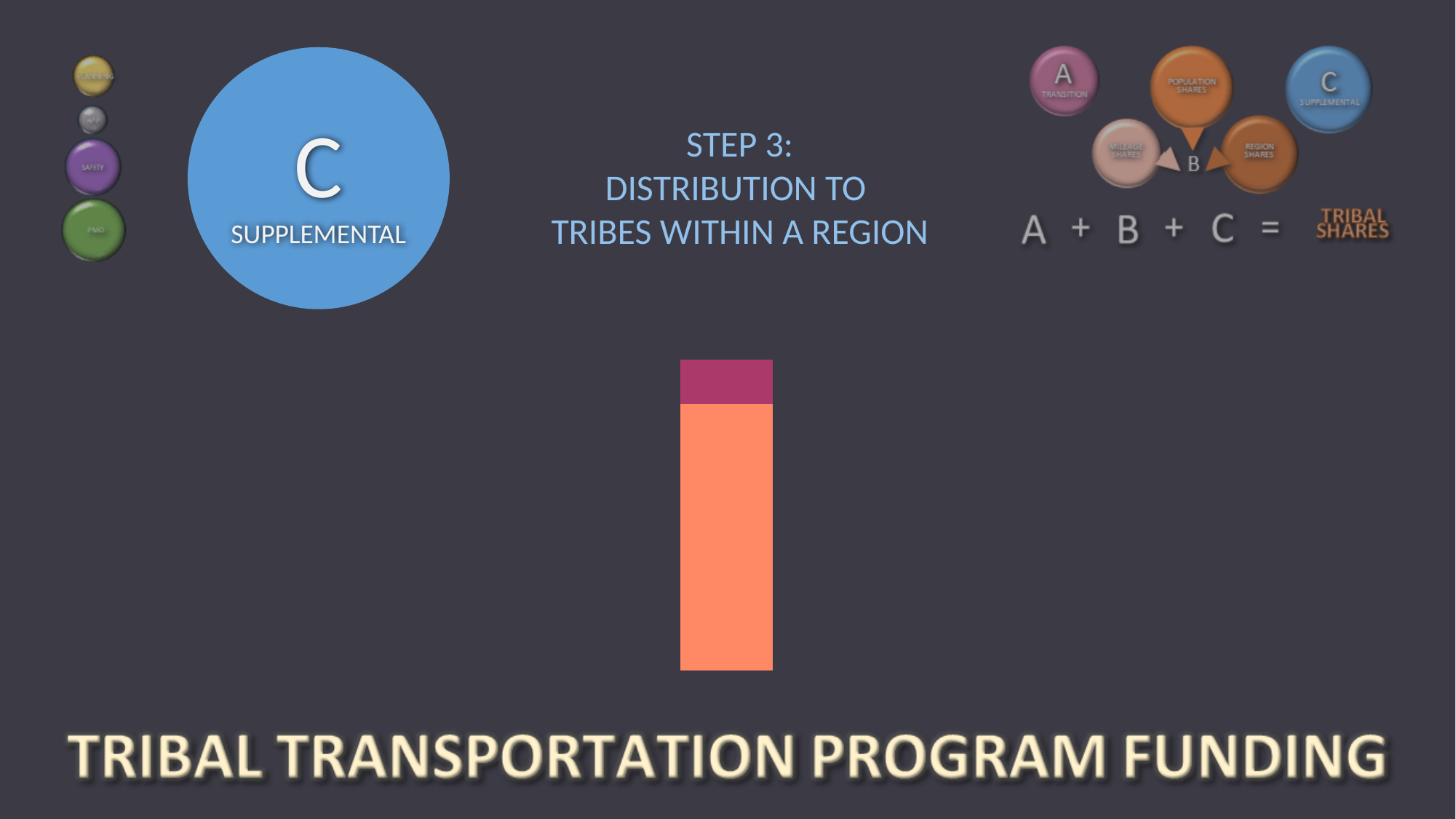
How many bars does the chart show? 1 How many segments make up the stacked bar? 2 Is the smaller segment of the stacked bar at the top or the bottom of the bar? top What kind of chart is shown in the centre of the slide? bar chart Which segment of the stacked bar is larger, the orange one or the magenta one? orange Does the chart display a legend? No